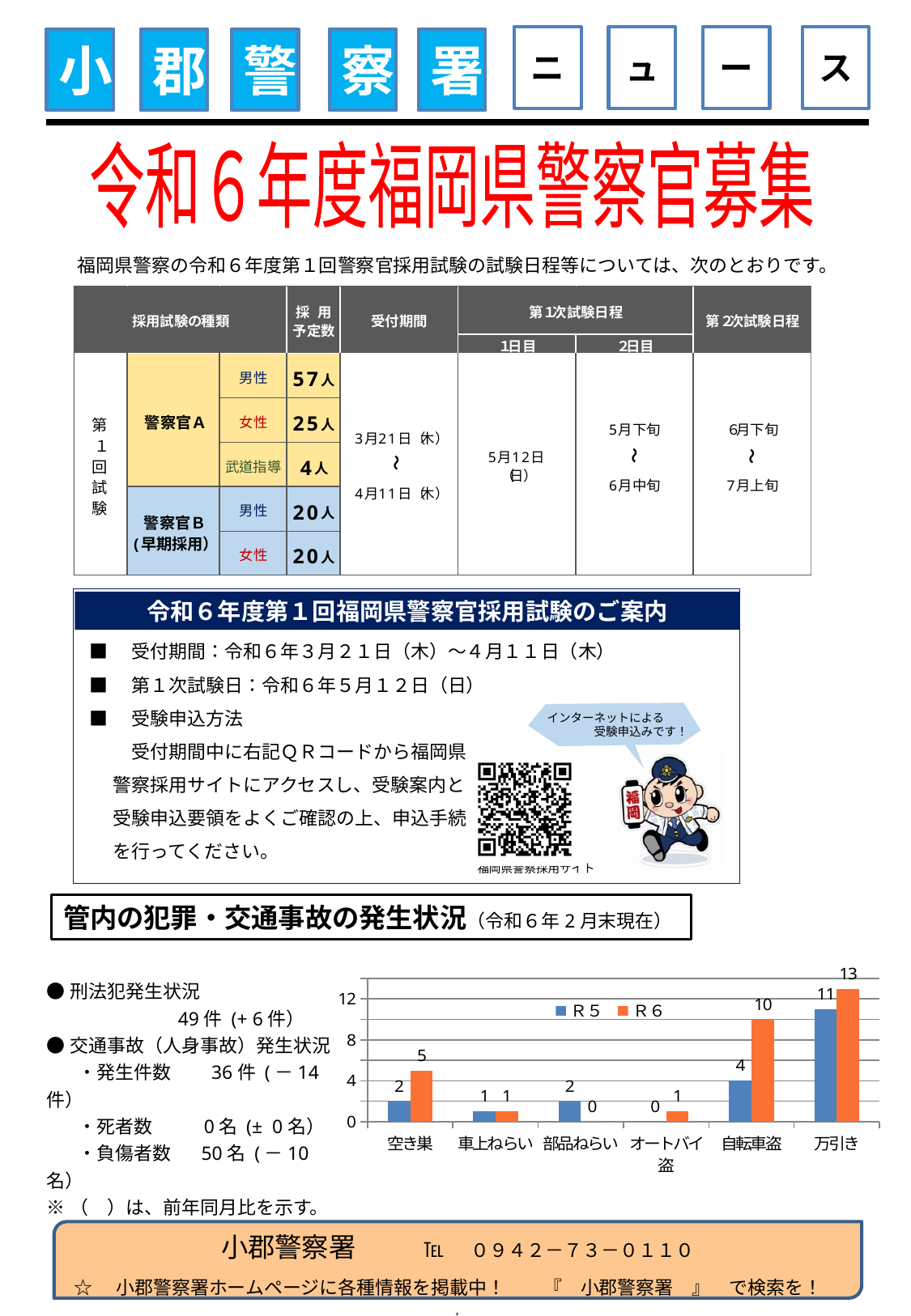
In the bar chart, which category has the lowest R5 value? オートバイ盗 What kind of chart is shown at the bottom of the slide? bar chart In the bar chart, what is the R5 value for 空き巣? 2 In the bar chart, which is larger for 部品ねらい, the R5 value or the R6 value? R5 In the bar chart, is the R6 value for 万引き greater or less than 12? greater In the bar chart, which colour represents the R6 series? orange In the bar chart, what is the difference between the R6 and R5 values for 自転車盗? 6 How many categories are shown on the x axis of the bar chart? 6 In the bar chart, what is the R6 value for 自転車盗? 10 How many series does the legend of the bar chart list? 2 In the bar chart, which category has the highest R6 value? 万引き In the bar chart, what is the R6 value for 万引き? 13